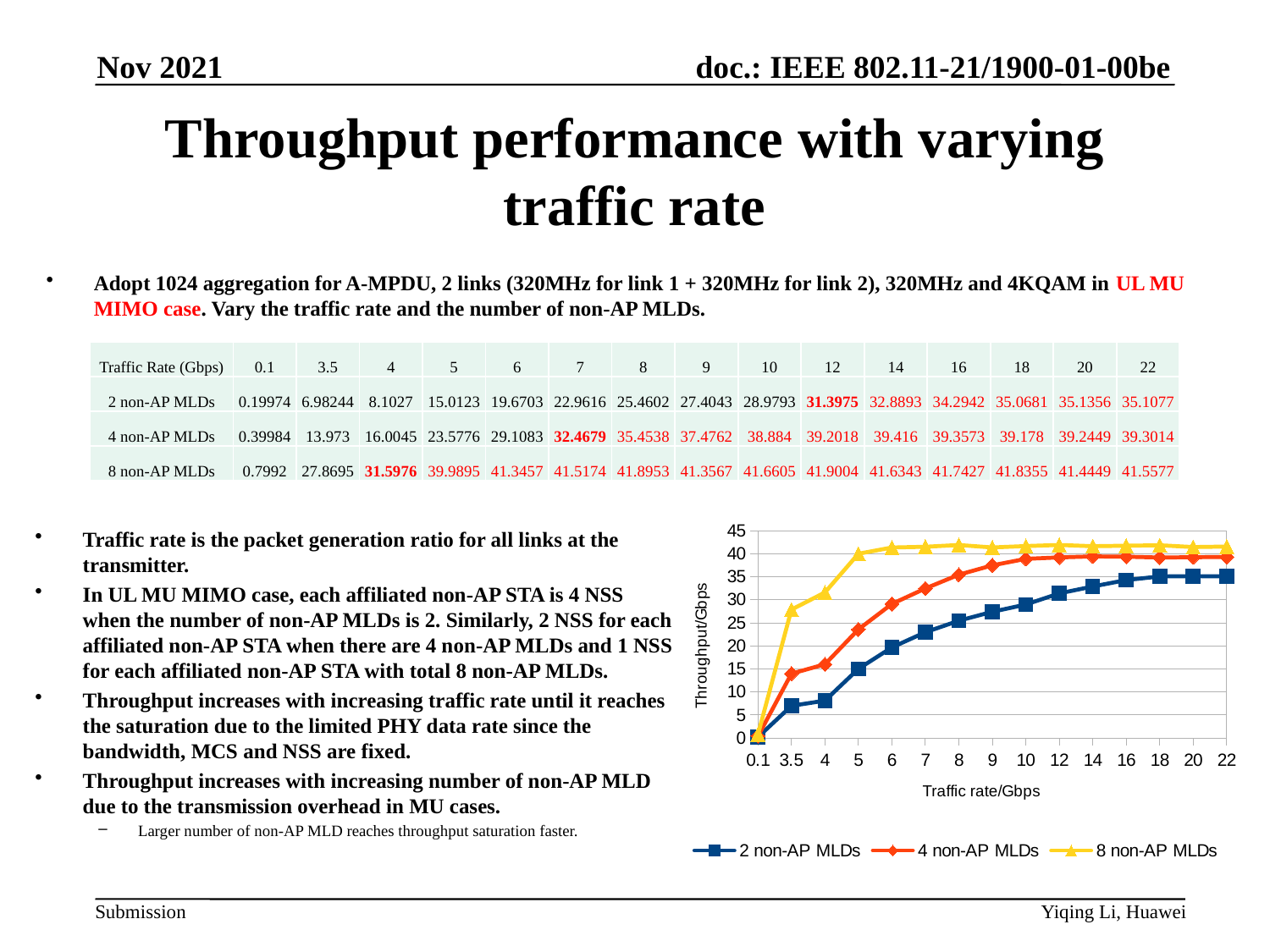
Is the throughput for 8 non-AP MLDs at a traffic rate of 5 Gbps greater or less than 35? greater Is the throughput for 2 non-AP MLDs at a traffic rate of 3.5 Gbps greater or less than 10? less What is the difference in throughput between 4 non-AP MLDs and 2 non-AP MLDs at a traffic rate of 7 Gbps? 9.5063 At a traffic rate of 6 Gbps, which series has the higher throughput, 2 non-AP MLDs or 4 non-AP MLDs? 4 non-AP MLDs How many traffic rate points are plotted along the x axis of the chart? 15 What is the throughput for 2 non-AP MLDs at a traffic rate of 22 Gbps? 35.1077 What is the label of the chart's y axis? Throughput/Gbps What is the throughput for 8 non-AP MLDs at a traffic rate of 4 Gbps? 31.5976 Does the throughput for 2 non-AP MLDs generally rise or fall as the traffic rate increases? rise Which series reaches the highest throughput in the chart? 8 non-AP MLDs How many series does the chart legend list? 3 What kind of chart is shown on the slide? line chart